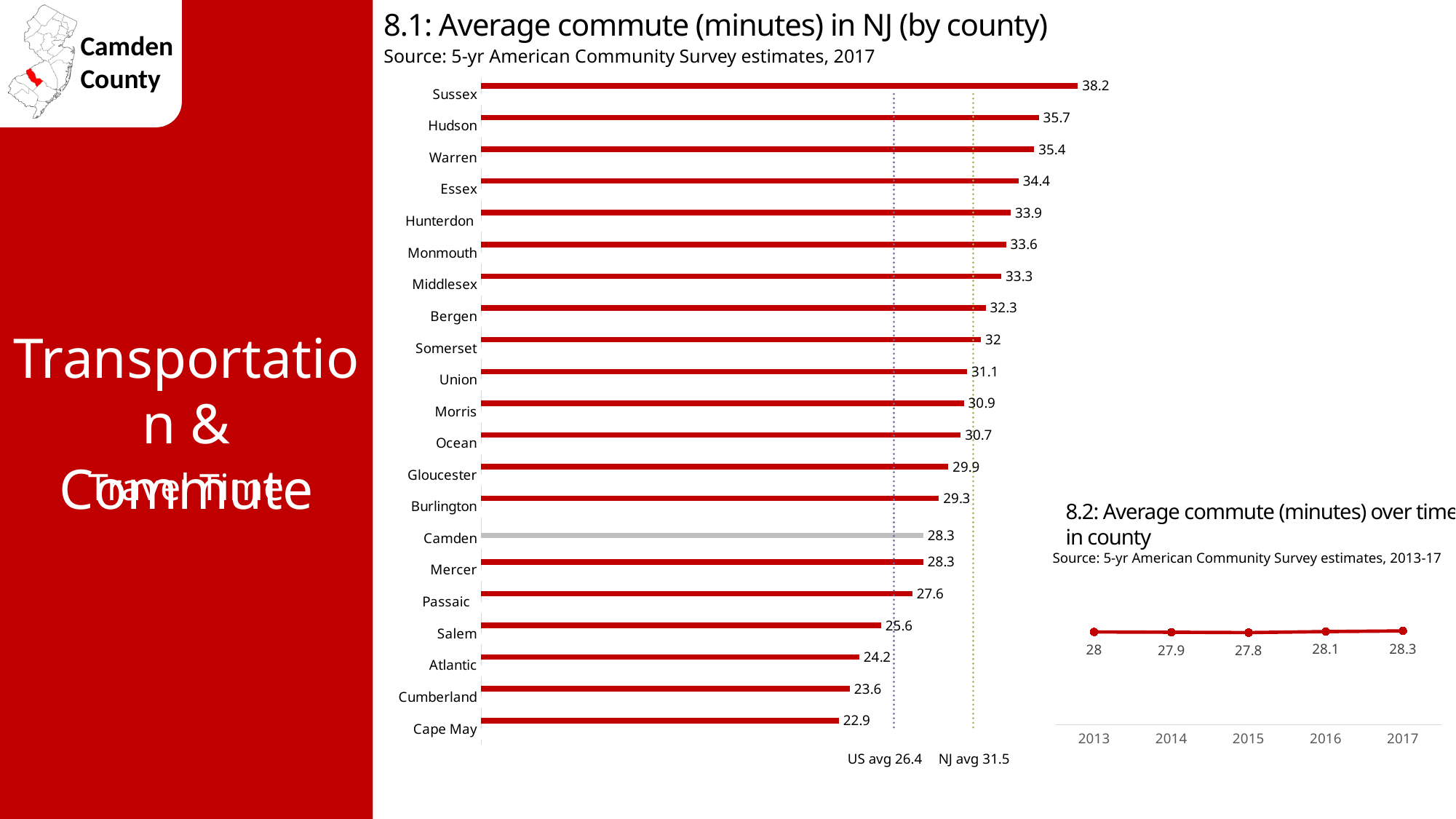
In chart 8.2 (Average commute over time in county), which year has the highest average commute? 2017 In chart 8.1 (Average commute in NJ by county), what NJ average is shown by the dotted reference line? 31.5 In chart 8.1 (Average commute in NJ by county), what is the average commute for Sussex? 38.2 What kind of chart is chart 8.1 (Average commute in NJ by county)? Bar chart What kind of chart is chart 8.2 (Average commute over time in county)? Line chart In chart 8.2 (Average commute over time in county), what was the average commute in 2015? 27.8 In chart 8.1 (Average commute in NJ by county), how many counties are shown? 21 In chart 8.1 (Average commute in NJ by county), which county has the lowest average commute? Cape May In chart 8.1 (Average commute in NJ by county), which county has the highest average commute? Sussex In chart 8.1 (Average commute in NJ by county), what is the difference between the average commute for Hudson and for Atlantic? 11.5 In chart 8.1 (Average commute in NJ by county), what is the average commute for Camden? 28.3 In chart 8.1 (Average commute in NJ by county), which has a longer average commute, Bergen or Ocean? Bergen